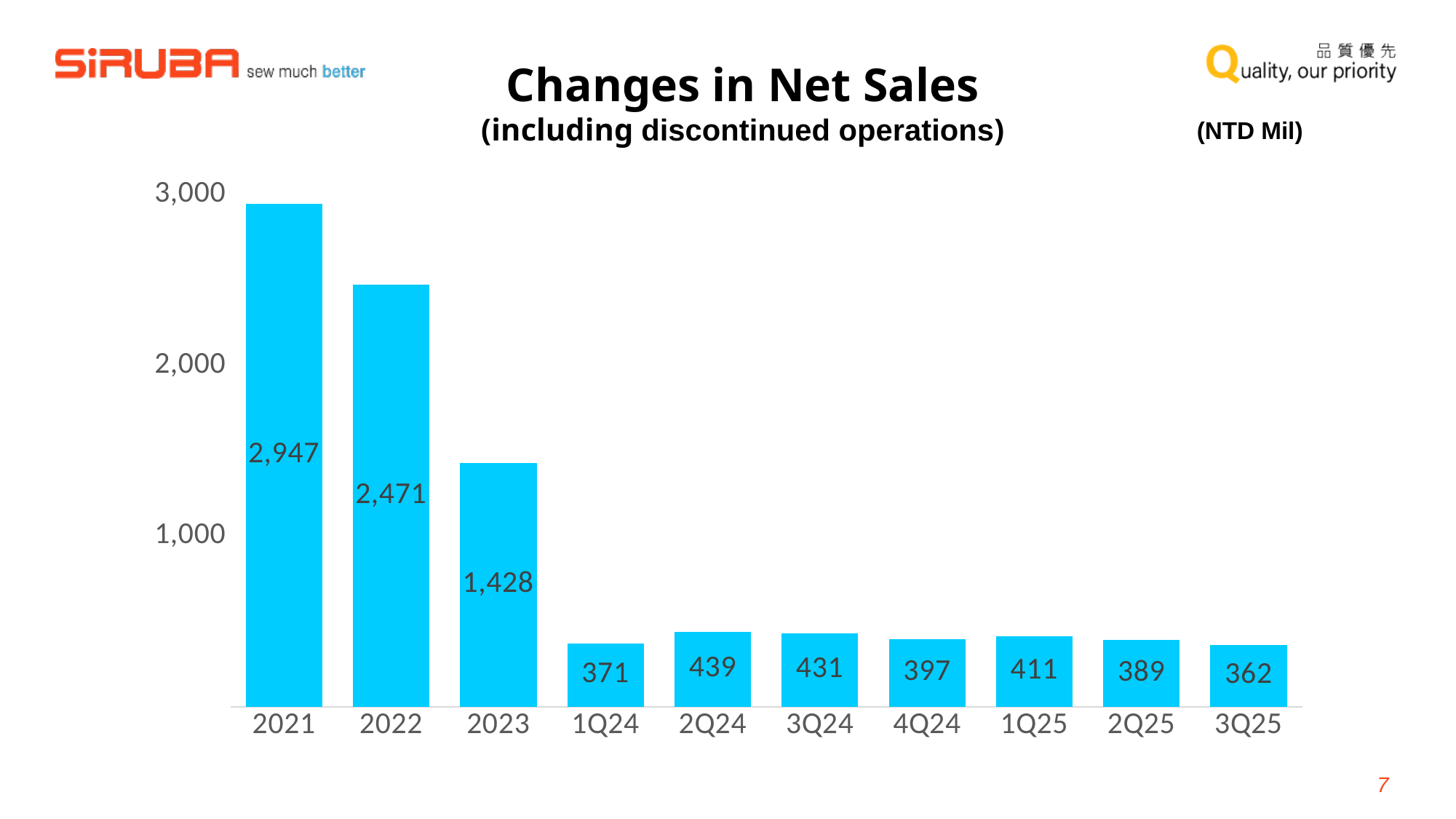
Which is larger, the net sales for 3Q24 or 4Q24? 3Q24 What is the net sales value for 2021? 2,947 What is the difference between the net sales for 2022 and 2023? 1,043 What is the title of the chart? Changes in Net Sales (including discontinued operations) Which category has the highest net sales? 2021 How many categories are shown on the x axis? 10 What kind of chart is shown on the slide? Bar chart What is the difference between the net sales for 1Q25 and 2Q25? 22 Which category has the lowest net sales? 3Q25 What is the net sales value for 2Q24? 439 What is the net sales value for 3Q25? 362 Is the value for 2023 greater or less than 1,000? greater